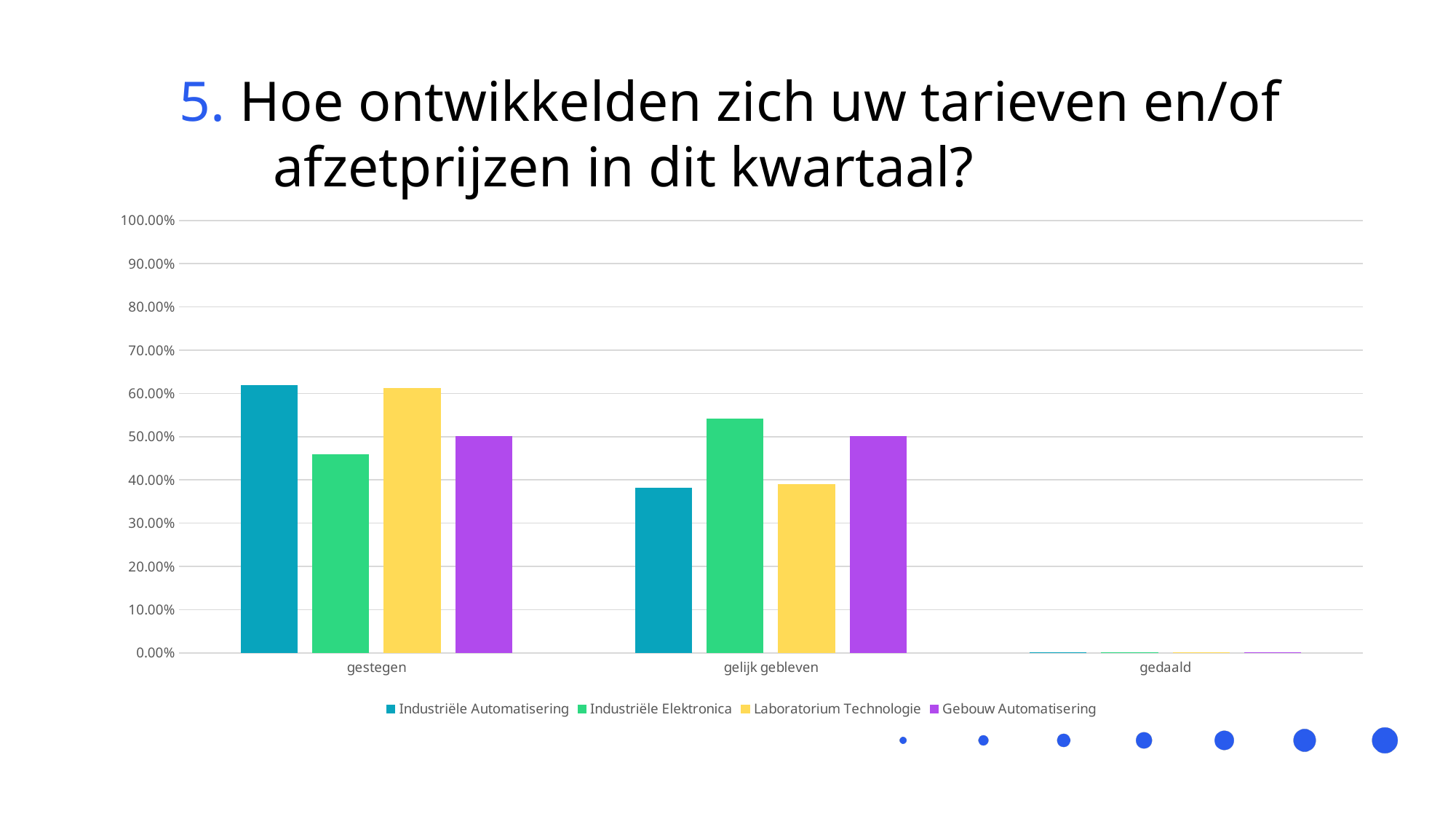
How many series does the chart's legend list? 4 For Laboratorium Technologie, which category has the larger value: 'gestegen' or 'gelijk gebleven'? gestegen Is the value for Industriële Automatisering in the 'gestegen' category greater or less than 50.00%? greater Is the value for Industriële Elektronica in the 'gelijk gebleven' category greater or less than 50.00%? greater What kind of chart is shown on the slide? bar chart Is the value for Industriële Automatisering in the 'gelijk gebleven' category greater or less than 50.00%? less For Industriële Elektronica, which category has the larger value: 'gestegen' or 'gelijk gebleven'? gelijk gebleven Which colour represents Laboratorium Technologie in the chart's legend? yellow Which series has the lowest value in the 'gestegen' category? Industriële Elektronica How many categories are shown on the x axis of the chart? 3 In the 'gestegen' category, which is larger: Industriële Automatisering or Industriële Elektronica? Industriële Automatisering